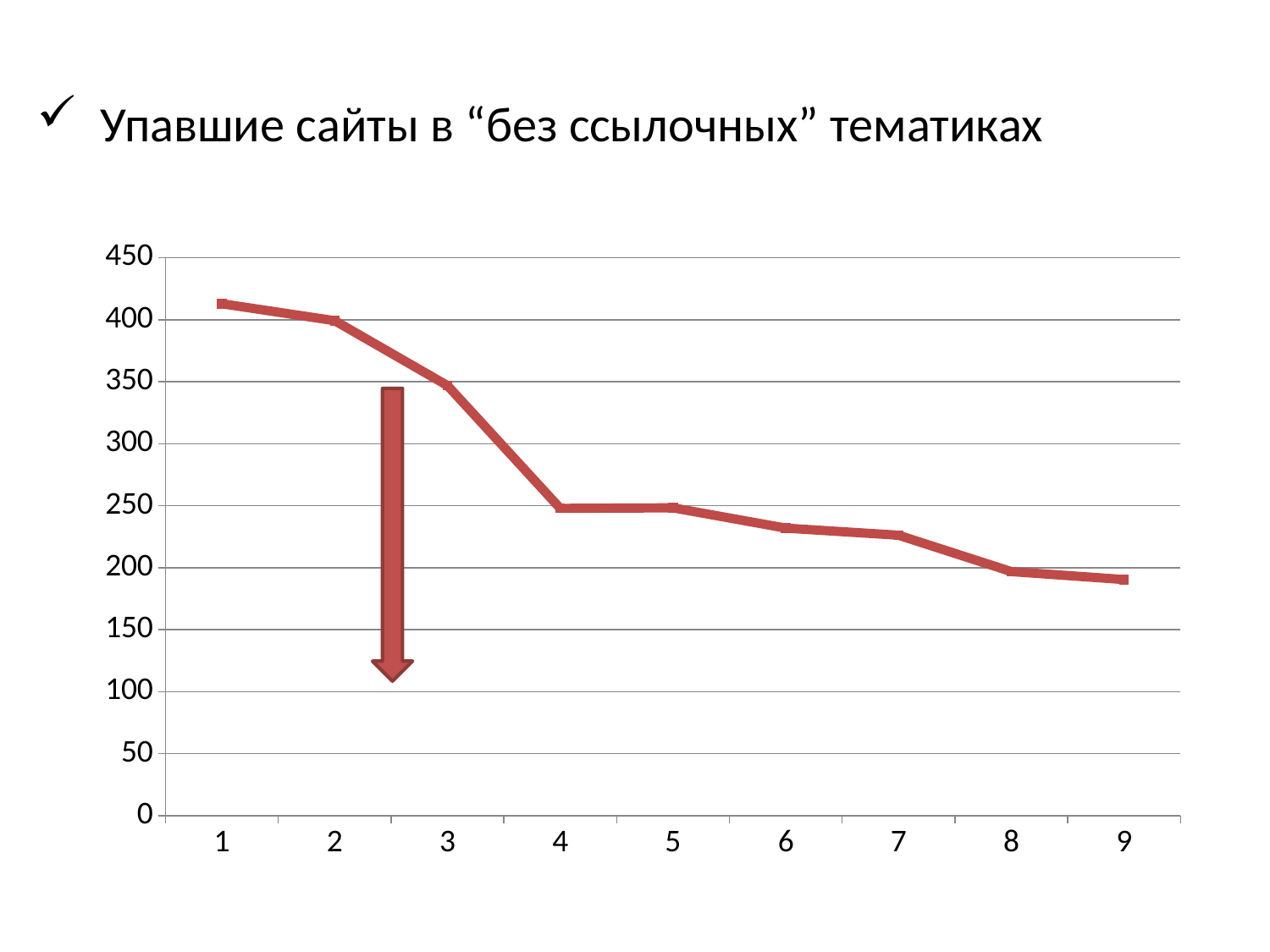
What kind of chart is shown on the slide? line chart Which is larger, the value at x = 1 or the value at x = 4? x = 1 What is the highest value shown on the y axis? 450 How many points are plotted along the x axis? 9 Is the value at x = 2 greater or less than 350? greater Do the values rise or fall as the x axis goes from 1 to 9? fall Which x-axis category has the highest value? 1 Is the value at x = 1 greater or less than 400? greater Is the value at x = 6 greater or less than 250? less Which x-axis category has the lowest value? 9